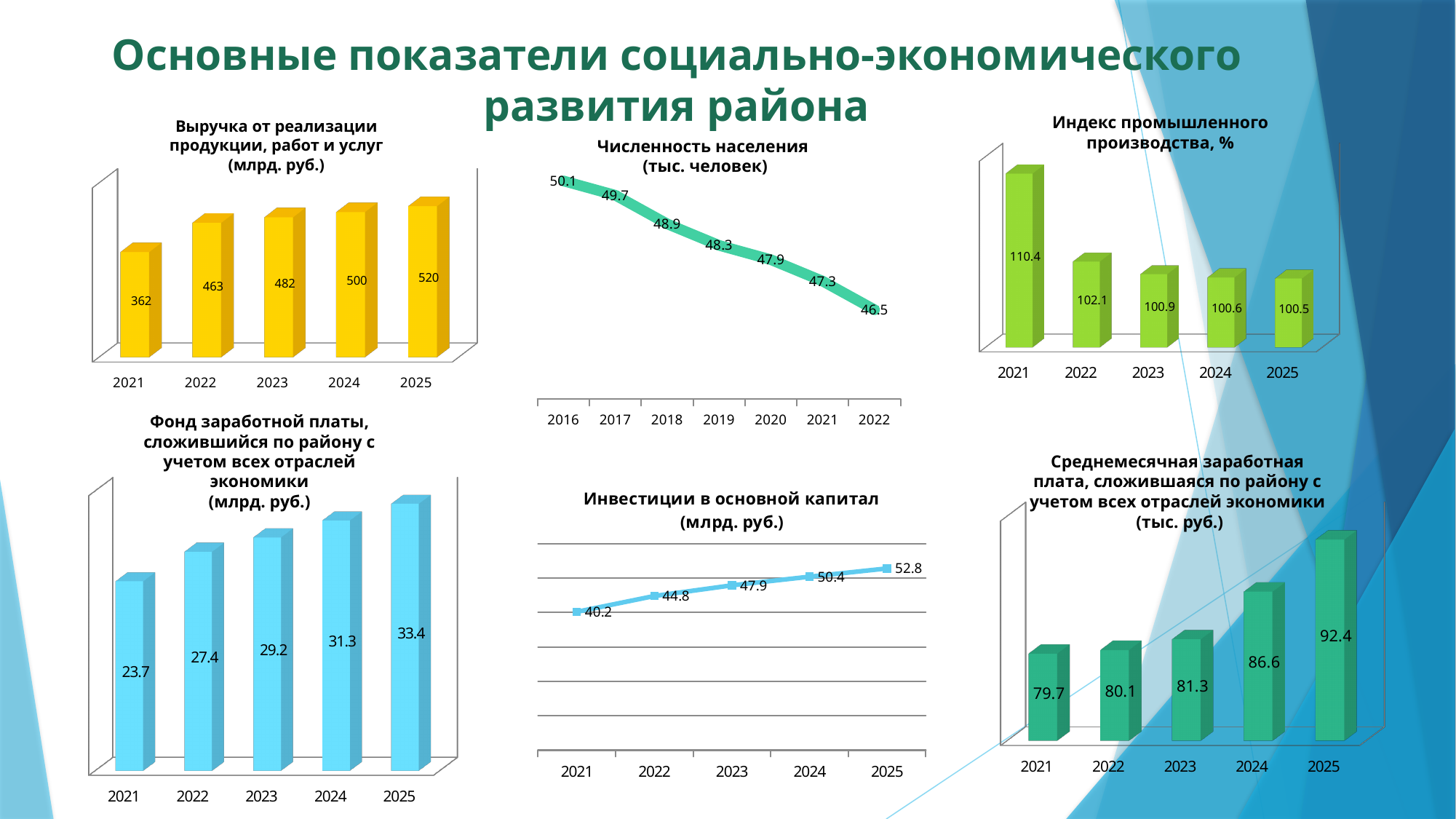
In the chart "Численность населения (тыс. человек)", what is the value for 2019? 48.3 In the chart "Индекс промышленного производства, %", what is the value for 2023? 100.9 In the chart "Численность населения (тыс. человек)", do the values rise or fall from 2016 to 2022? fall In the chart "Индекс промышленного производства, %", which year has the highest value? 2021 What kind of chart is "Инвестиции в основной капитал (млрд. руб.)"? line chart In the chart "Инвестиции в основной капитал (млрд. руб.)", what is the value for 2022? 44.8 In the chart "Фонд заработной платы, сложившийся по району с учетом всех отраслей экономики (млрд. руб.)", what is the value for 2024? 31.3 In the chart "Выручка от реализации продукции, работ и услуг (млрд. руб.)", what is the difference between the 2025 and 2021 values? 158 In the chart "Численность населения (тыс. человек)", how many years are plotted? 7 In the chart "Среднемесячная заработная плата, сложившаяся по району с учетом всех отраслей экономики (тыс. руб.)", which is larger: the value for 2024 or the value for 2023? 2024 In the chart "Фонд заработной платы, сложившийся по району с учетом всех отраслей экономики (млрд. руб.)", which year has the lowest value? 2021 In the chart "Выручка от реализации продукции, работ и услуг (млрд. руб.)", what is the value for 2021? 362